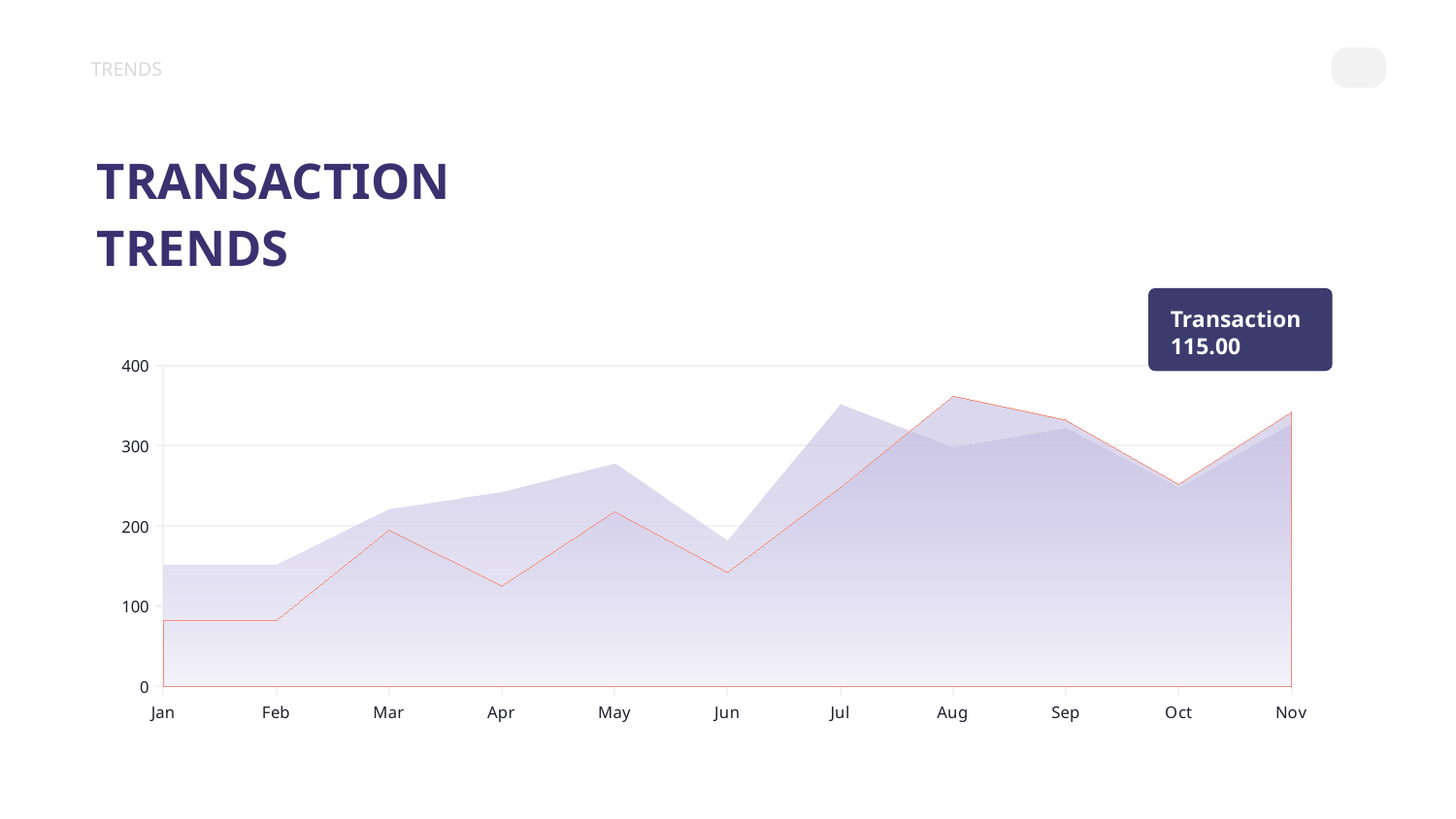
Is the value of the shaded area for Jan greater or less than 100? greater Is the value of the shaded area for May greater or less than 200? greater What kind of chart is shown on the slide? area chart What is the title of the slide containing the chart? TRANSACTION TRENDS Is the value of the red line for Aug greater or less than 300? greater In which month does the shaded area reach its highest value? Jul Does the red line rise or fall from Aug to Oct? fall How many months are plotted along the x axis? 11 What value is shown in the dark callout box above the chart? 115.00